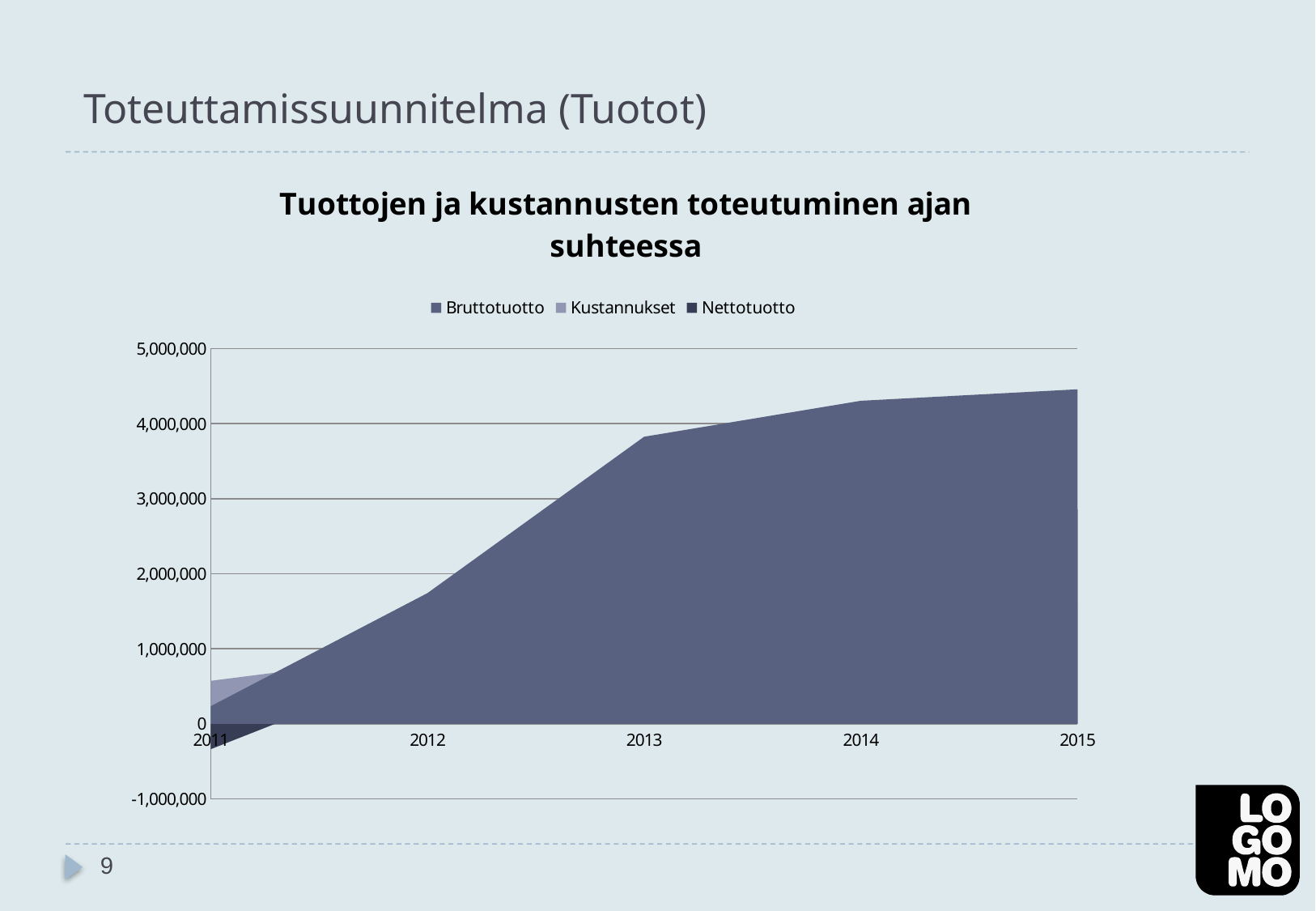
Which series are listed in the chart legend? Bruttotuotto, Kustannukset, Nettotuotto Is the Kustannukset value in 2011 greater or less than 1,000,000? less Is the highest plotted value in 2013 greater or less than 3,000,000? greater Is the highest plotted value in 2012 greater or less than 2,000,000? less Does the top of the plotted area rise or fall from 2011 to 2015? rise Which year has the highest plotted value on the chart? 2015 What is the title of the chart? Tuottojen ja kustannusten toteutuminen ajan suhteessa What kind of chart is shown on the slide? area chart How many years are shown along the x axis of the chart? 5 How many series does the chart legend list? 3